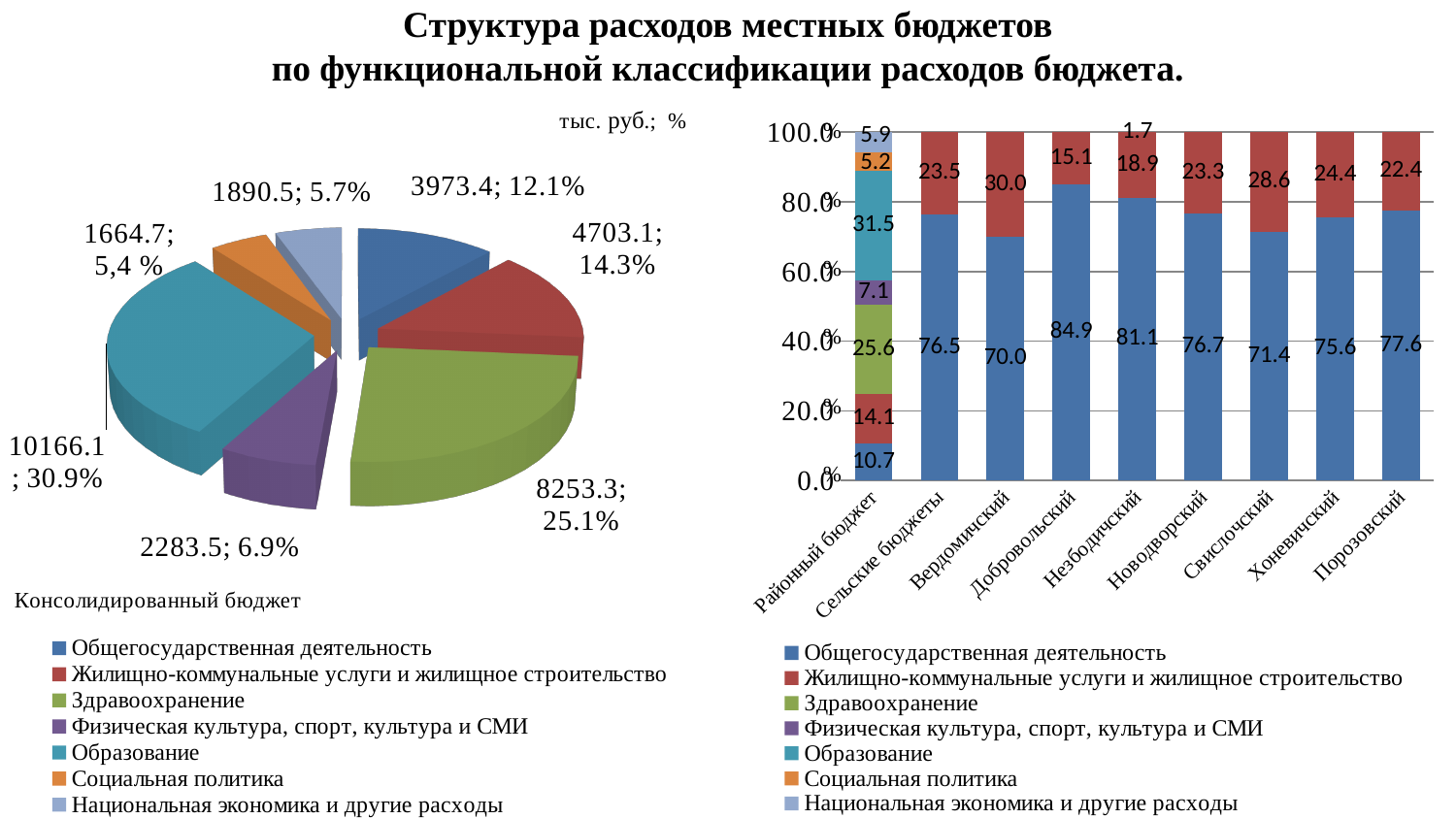
On the stacked bar chart (right), what is the value of Образование for Районный бюджет? 31.5 On the stacked bar chart (right), how many categories are shown on the x axis? 9 On the stacked bar chart (right), which category has the highest value for Общегосударственная деятельность? Добровольский On the pie chart (left), which category has the smallest slice? Социальная политика On the stacked bar chart (right), what is the difference between the Общегосударственная деятельность values for Незбодичский and Свислочский? 9.7 On the stacked bar chart (right), what is the value of Общегосударственная деятельность for Добровольский? 84.9 On the pie chart (left), which category has the largest slice? Образование On the stacked bar chart (right), how many series does the legend list? 7 On the pie chart (left), how many slices are there? 7 On the pie chart (left), what is the share of Образование? 30.9% On the pie chart (left), what value is shown for Здравоохранение? 8253.3 On the stacked bar chart (right), what is the value of Жилищно-коммунальные услуги и жилищное строительство for Вердомичский? 30.0